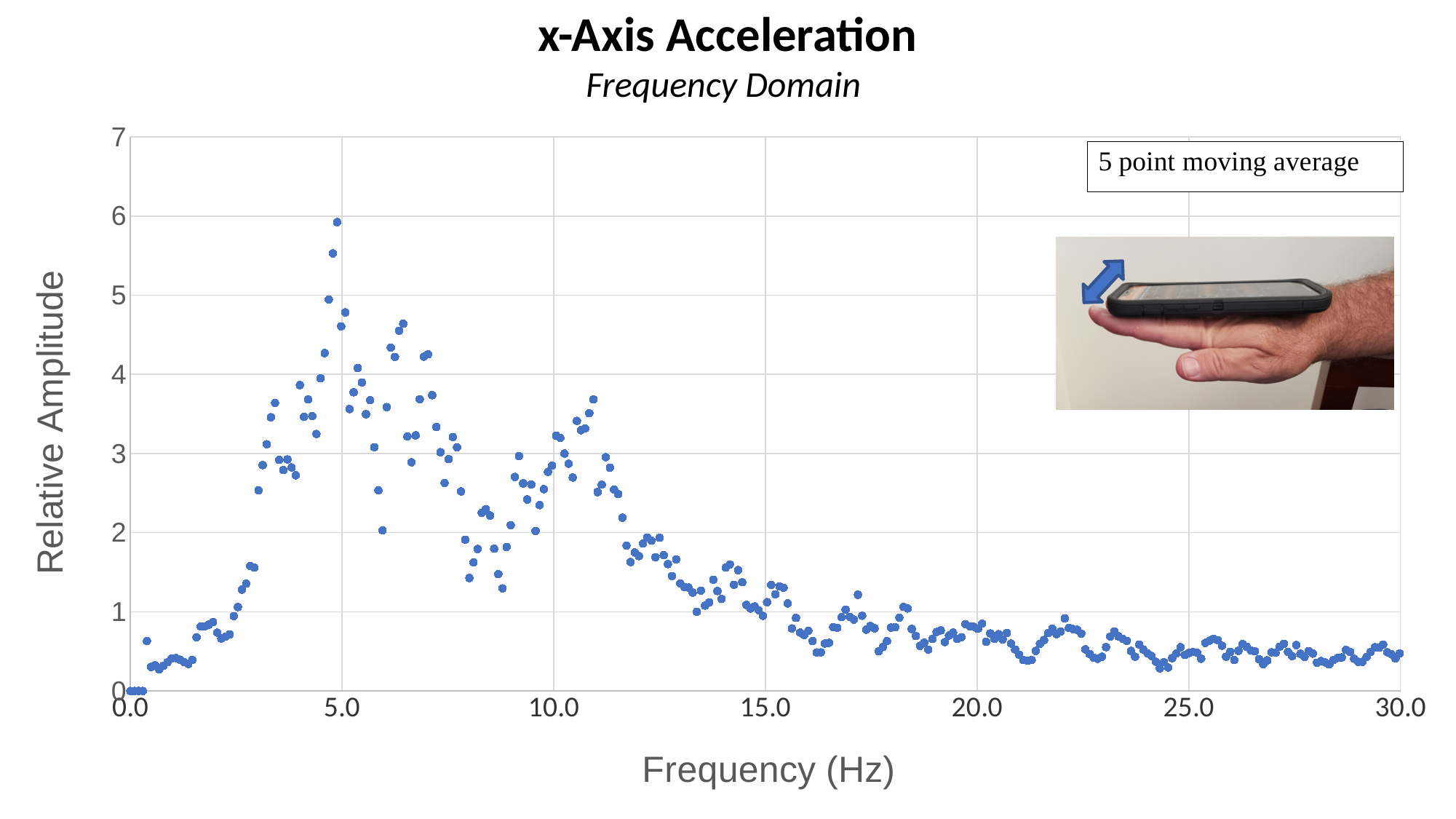
Is the relative amplitude at 30.0 Hz greater or less than 1? less What is the title of the chart? x-Axis Acceleration Which has the larger relative amplitude: the points near 10.0 Hz or the points near 20.0 Hz? near 10.0 Hz Is the relative amplitude at 10.0 Hz greater or less than 2? greater Is the relative amplitude at 15.0 Hz greater or less than 2? less What kind of chart is shown on the slide? Scatter plot What does the text box in the upper right of the chart say? 5 point moving average Which has the larger relative amplitude: the points near 5.0 Hz or the points near 25.0 Hz? near 5.0 Hz Do the relative amplitude values generally rise or fall as frequency increases from 0.0 Hz to 5.0 Hz? rise Do the relative amplitude values generally rise or fall as frequency increases from 5.0 Hz to 30.0 Hz? fall